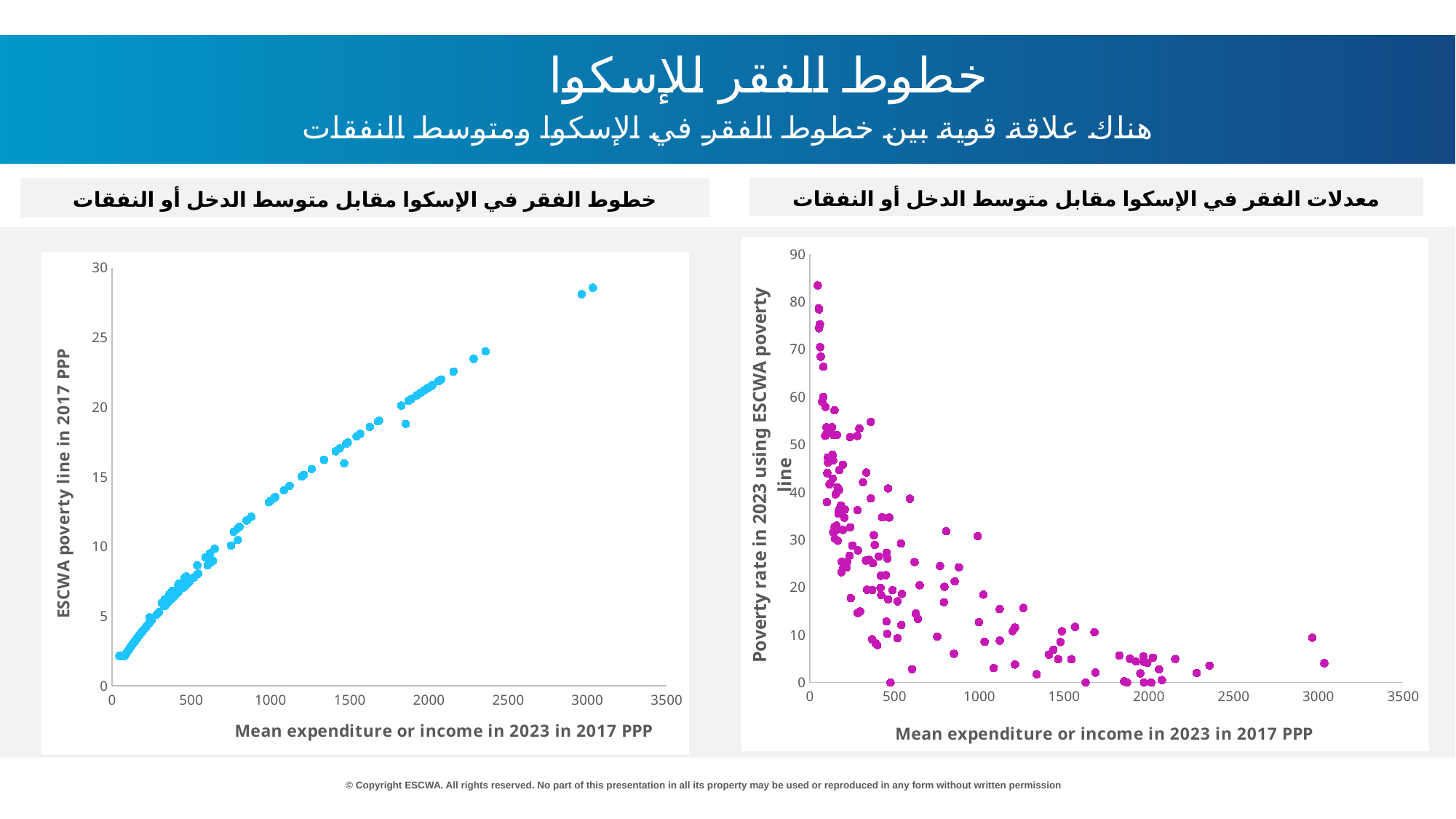
What is the maximum value shown on the y-axis of the right chart? 90 In the right chart, are the poverty rate values for the points at a mean expenditure of about 3000 greater or less than 20? less In the left chart, is the poverty line value for the point at a mean expenditure of about 1000 greater or less than 20? less In the left chart, do the ESCWA poverty line values rise or fall as mean expenditure or income increases? Rise What is the y-axis title of the left chart? ESCWA poverty line in 2017 PPP In the left chart, are the poverty line values for the points at a mean expenditure of about 500 greater or less than 10? less What kind of chart is the left chart (ESCWA poverty line vs mean expenditure)? Scatter chart What kind of chart is the right chart (poverty rate vs mean expenditure)? Scatter chart What is the x-axis title of the right chart? Mean expenditure or income in 2023 in 2017 PPP In the right chart, do the poverty rate values rise or fall as mean expenditure or income increases? Fall